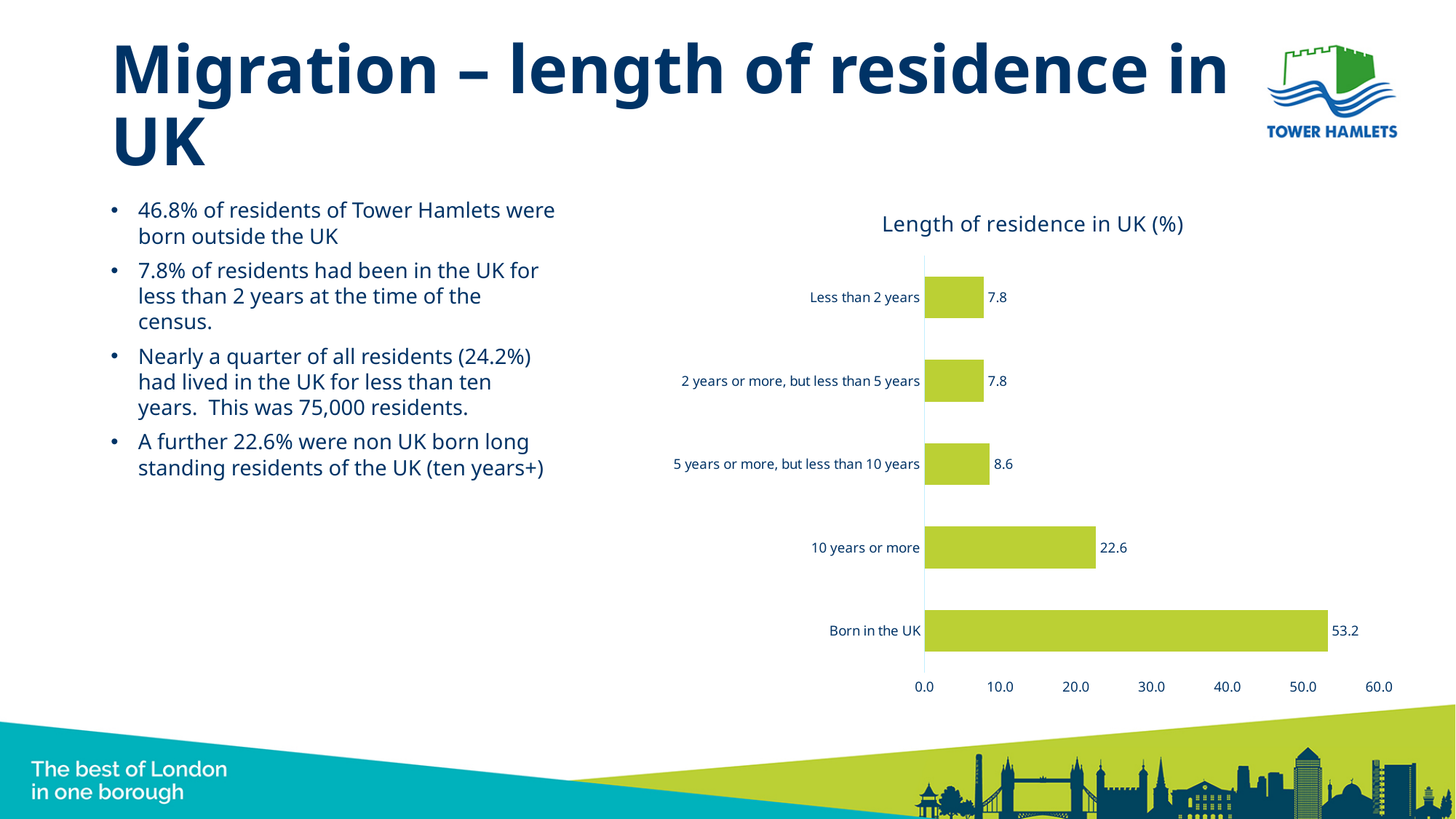
Which category has the highest value in the chart? Born in the UK What is the value for '10 years or more' in the chart? 22.6 Is the value for 'Born in the UK' greater or less than 50.0? greater What is the difference between the values for '5 years or more, but less than 10 years' and 'Less than 2 years'? 0.8 What kind of chart is shown on the slide? Bar chart What is the value for '5 years or more, but less than 10 years' in the chart? 8.6 How many categories are shown in the chart? 5 Which is larger: the value for '10 years or more' or the value for '5 years or more, but less than 10 years'? 10 years or more What is the title of the chart on the slide? Length of residence in UK (%) What is the value for 'Born in the UK' in the Length of residence in UK (%) chart? 53.2 What is the value for 'Less than 2 years' in the chart? 7.8 What is the difference between the values for 'Born in the UK' and '10 years or more'? 30.6